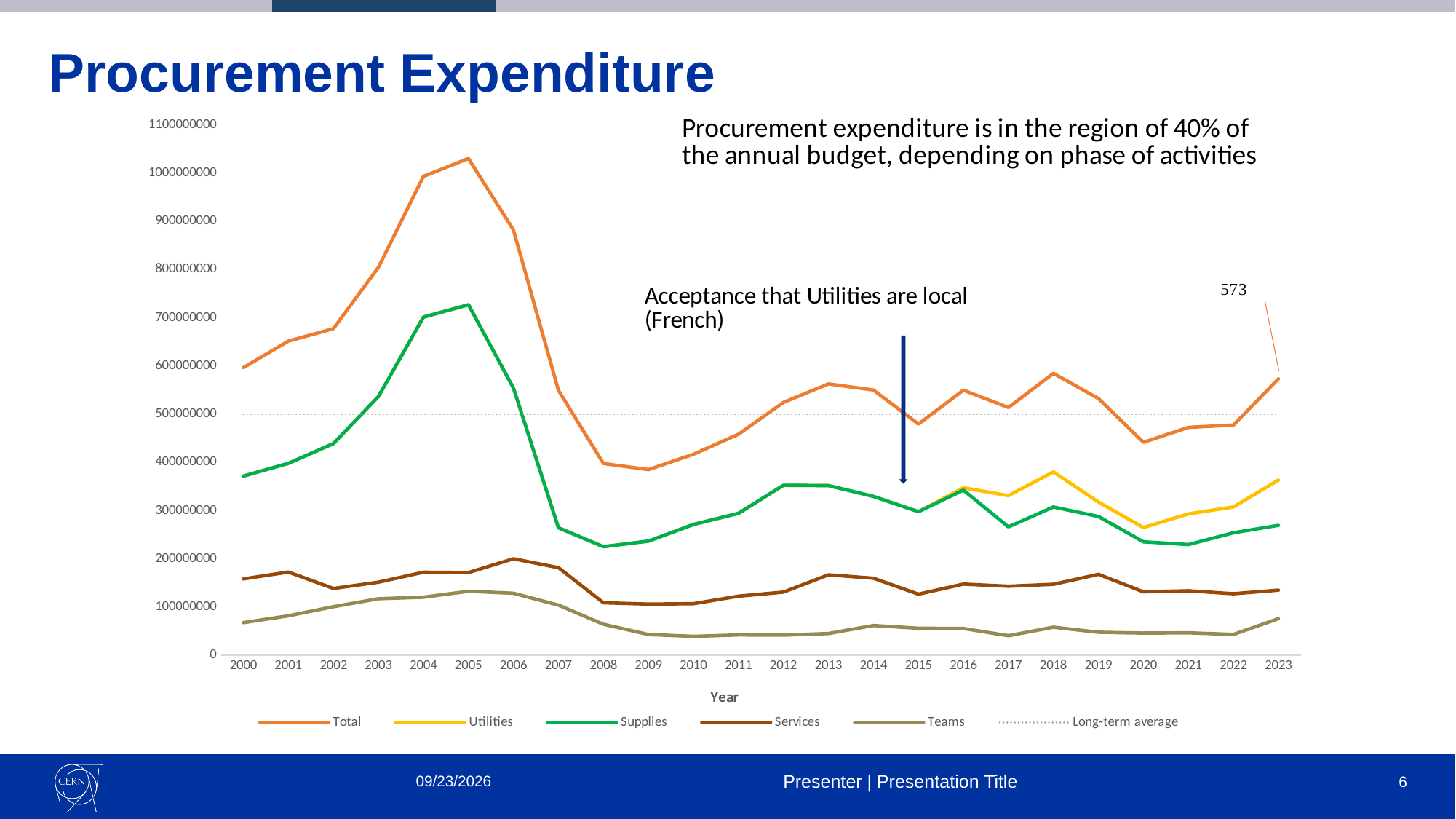
How many years are plotted along the x axis? 24 What is the title of the x axis? Year In which year does the Total series reach its highest value? 2005 How many series does the legend list? 6 Is the value of the Total series in 2005 greater or less than 1000000000? greater Which is larger, the Total value in 2004 or the Total value in 2007? 2004 What type of chart is shown on the slide? line chart In 2018, which is larger, Utilities or Supplies? Utilities Is the value of the Supplies series in 2008 greater or less than 300000000? less What data label is shown for the Total series in 2023? 573 Which series has the lowest values across the whole period? Teams Does the Total series rise or fall between 2005 and 2009? fall